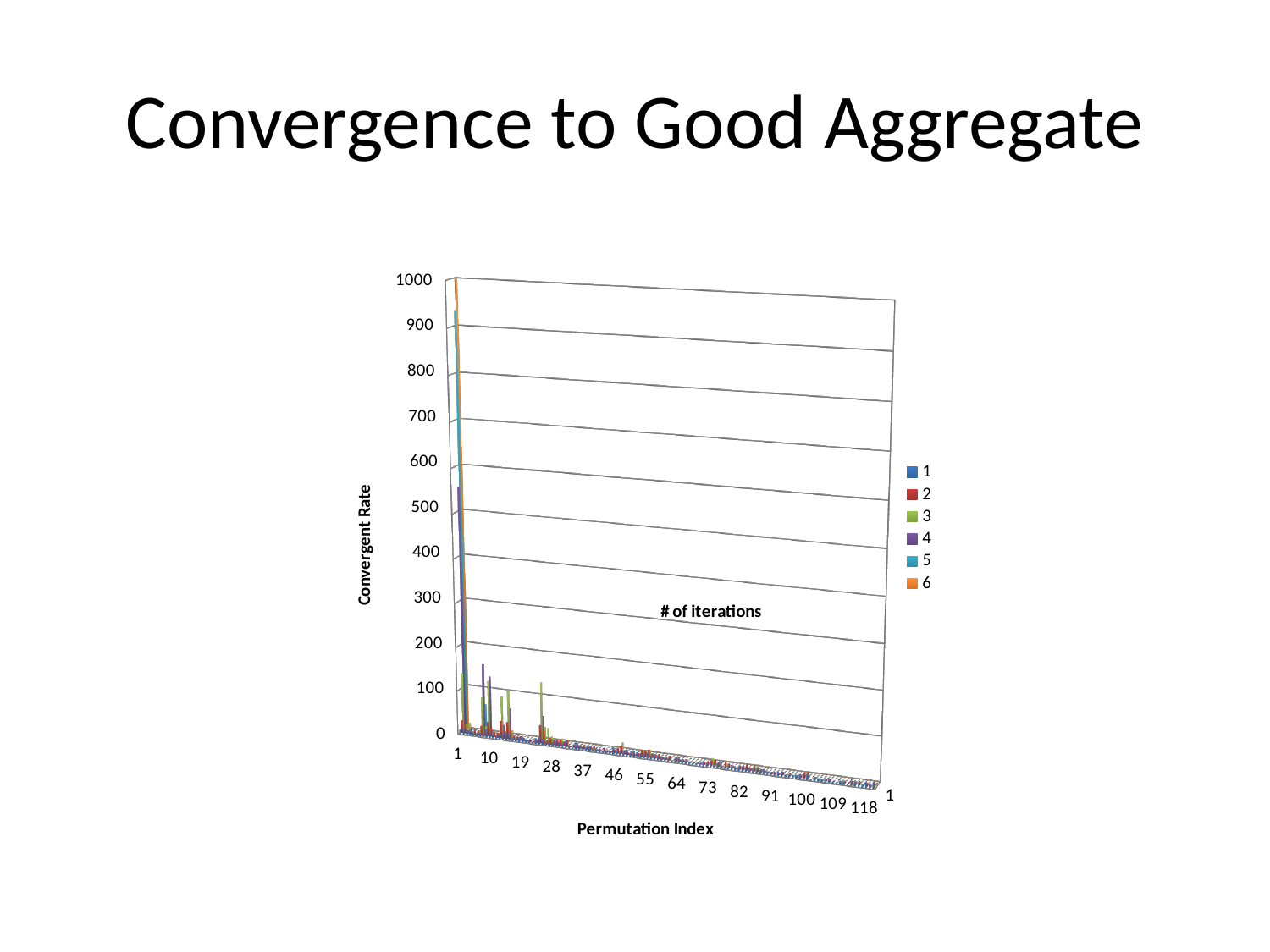
Is the value for series 1 at permutation index 1 greater or less than 200? less At permutation index 1, is the value for series 6 larger or smaller than the value for series 4? larger Is the value for series 4 at permutation index 1 greater or less than 400? greater What kind of chart is shown on the slide? bar chart Which series has the highest value at permutation index 1? 6 What is the title of the vertical axis? Convergent Rate At which permutation index do the highest values occur? 1 How many series does the legend list? 6 Is the value for series 6 at permutation index 1 greater or less than 900? greater Do the values generally rise or fall as the permutation index increases along the x axis? fall What is the title of the horizontal axis? Permutation Index